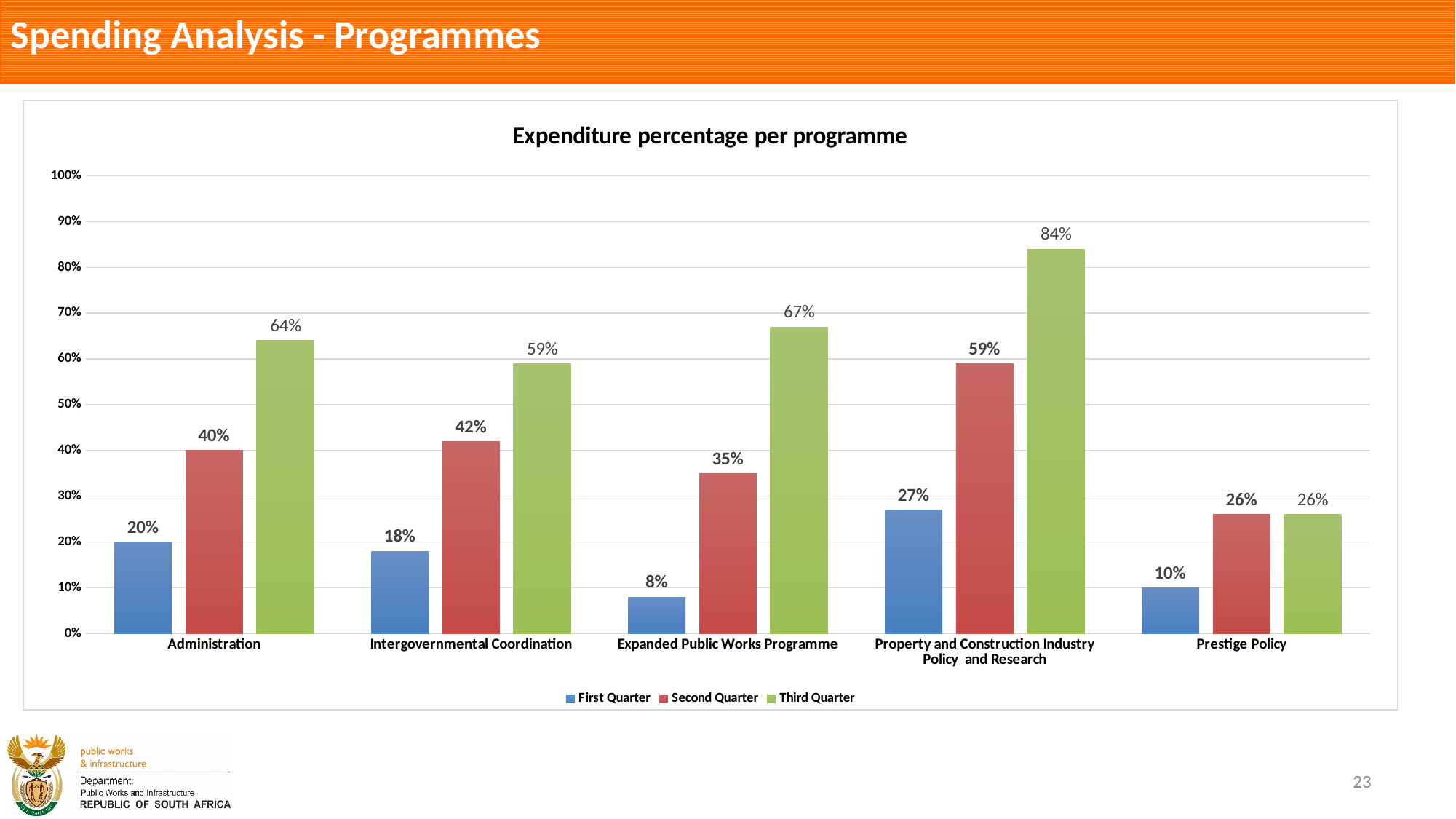
What is the First Quarter expenditure percentage for Expanded Public Works Programme? 8% Which programme has the lowest First Quarter expenditure percentage? Expanded Public Works Programme Is the Third Quarter value for Prestige Policy greater or less than 30%? less What is the difference between the Third Quarter and Second Quarter expenditure percentages for Expanded Public Works Programme? 32% How many series does the legend list? 3 How many programmes are shown on the x axis? 5 Which programme has the highest Third Quarter expenditure percentage? Property and Construction Industry Policy and Research What is the Third Quarter expenditure percentage for Administration? 64% Which is larger: the Second Quarter value for Intergovernmental Coordination or the Second Quarter value for Administration? Intergovernmental Coordination What is the title of the chart? Expenditure percentage per programme What kind of chart is shown on the slide? Bar chart What is the Second Quarter expenditure percentage for Property and Construction Industry Policy and Research? 59%